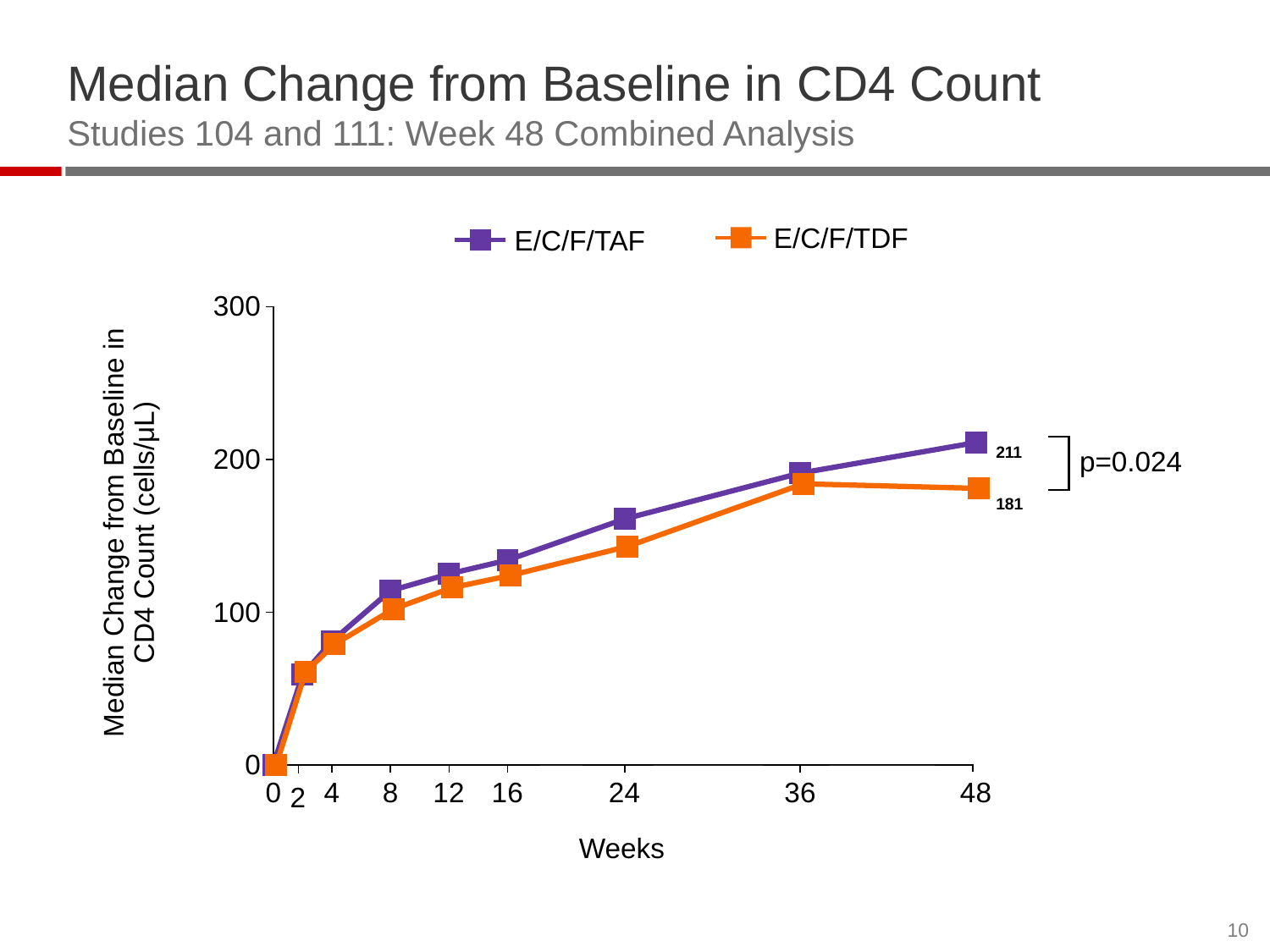
What is the median change from baseline in CD4 count at week 48 for E/C/F/TDF? 181 How many time points are labelled on the x axis? 9 What is the median change from baseline in CD4 count at week 48 for E/C/F/TAF? 211 Is the value for E/C/F/TAF at week 8 greater or less than 100? greater What p-value is shown next to the week 48 values? p=0.024 Is the value for E/C/F/TDF at week 24 greater or less than 200? less Is the value for E/C/F/TDF at week 2 greater or less than 100? less What is the difference between the week 48 values for E/C/F/TAF and E/C/F/TDF? 30 What kind of chart is shown on the slide? Line chart At week 48, which treatment has the larger median change from baseline in CD4 count? E/C/F/TAF Does the E/C/F/TAF line rise or fall from week 0 to week 48? Rise How many series does the legend list? 2